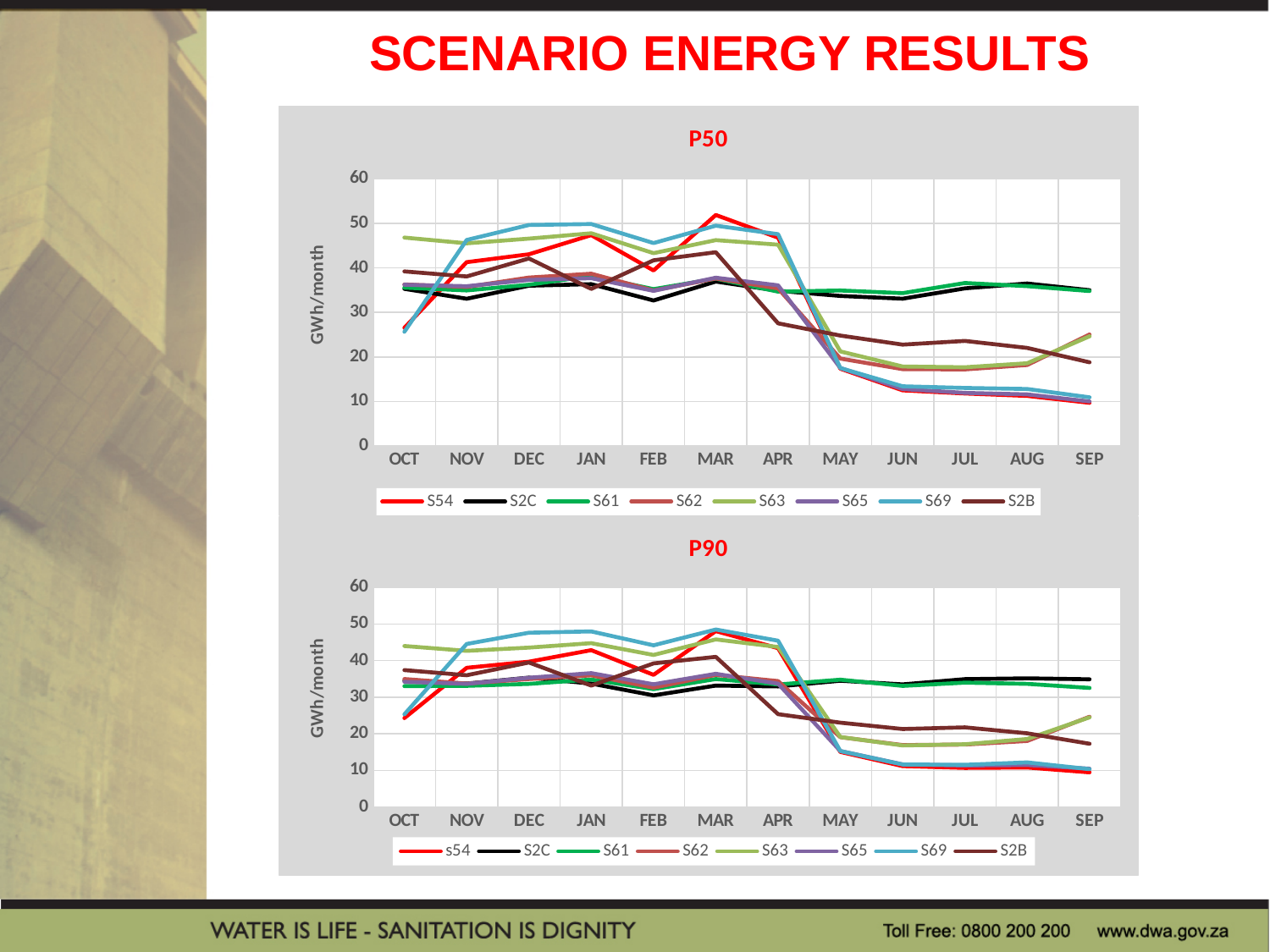
In the P50 chart, which series has the highest value in MAR? S54 In the P50 chart, is the value for S2B in JUL greater or less than 20? greater In the P50 chart, which is larger in OCT, S63 or S54? S63 In the P90 chart, is the value for S54 in OCT greater or less than 30? less In the P50 chart, does the S2B series rise or fall from MAR to JUN? fall In the P50 chart, is the value for S54 in MAR greater or less than 50? greater How many months are shown on the x axis of the P90 chart? 12 What kind of chart is the P50 chart? line chart What is the y-axis label of the P90 chart? GWh/month In the P90 chart, which is larger in MAR, s54 or S2C? s54 How many series does the legend of the P50 chart list? 8